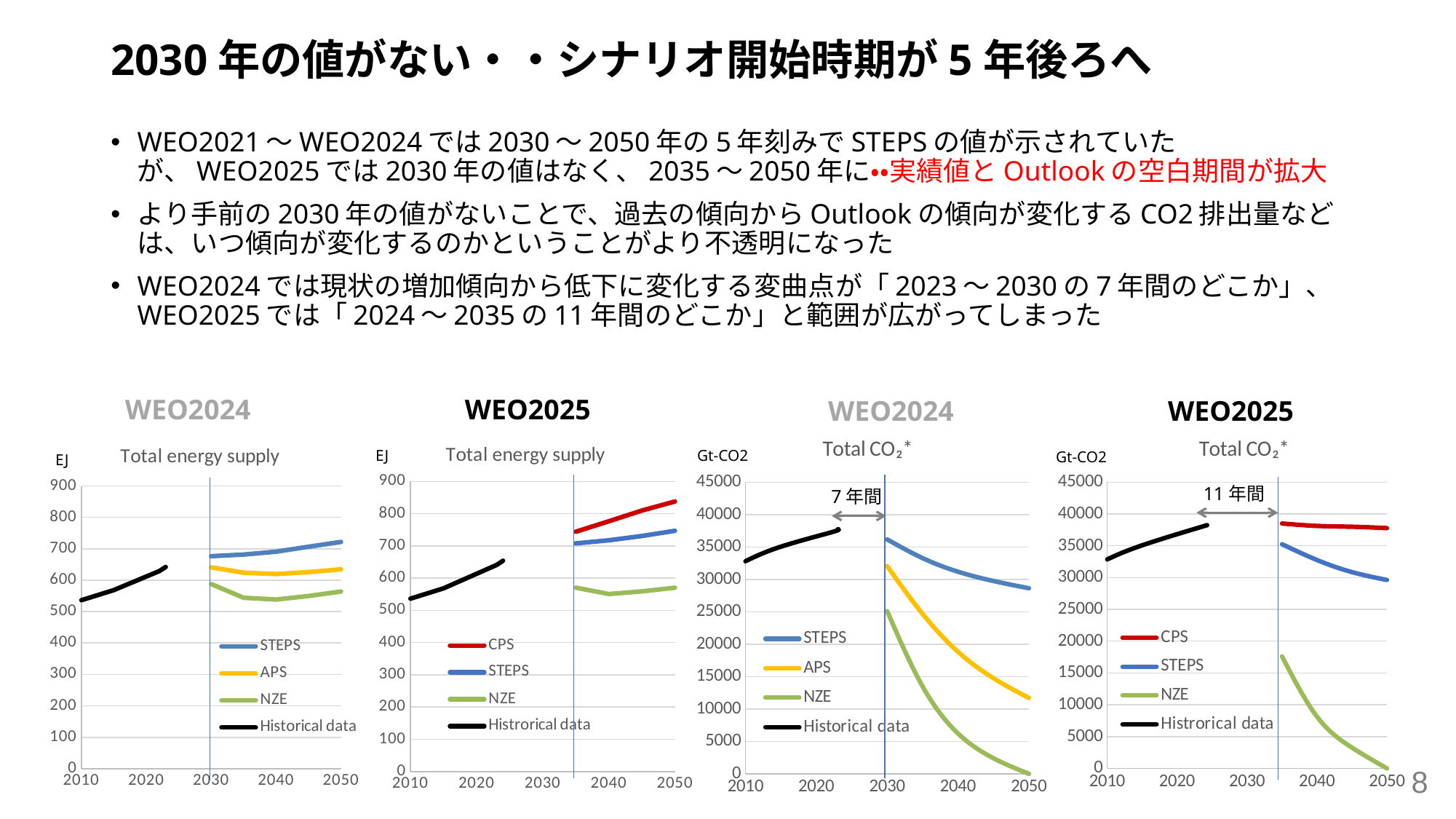
What unit is shown on the y axis of the WEO2024 Total CO2 chart? Gt-CO2 In the WEO2025 Total CO2 chart, which series is lowest in 2050? NZE In the WEO2025 Total energy supply chart, is the CPS value in 2050 greater or less than 800? greater In the WEO2024 Total CO2 chart, is the APS value in 2050 greater or less than 10000? greater In the WEO2024 Total CO2 chart, does the STEPS line rise or fall from 2030 to 2050? fall What kind of chart is the WEO2024 Total energy supply chart (leftmost)? line chart In the WEO2025 Total CO2 chart, which is larger in 2050, CPS or STEPS? CPS How many series does the legend of the WEO2025 Total energy supply chart list? 4 In the WEO2025 Total energy supply chart, which series is highest in 2050? CPS In the WEO2024 Total energy supply chart, does the STEPS line rise or fall from 2030 to 2050? rise In the WEO2024 Total energy supply chart, is the NZE value in 2050 greater or less than 600? less